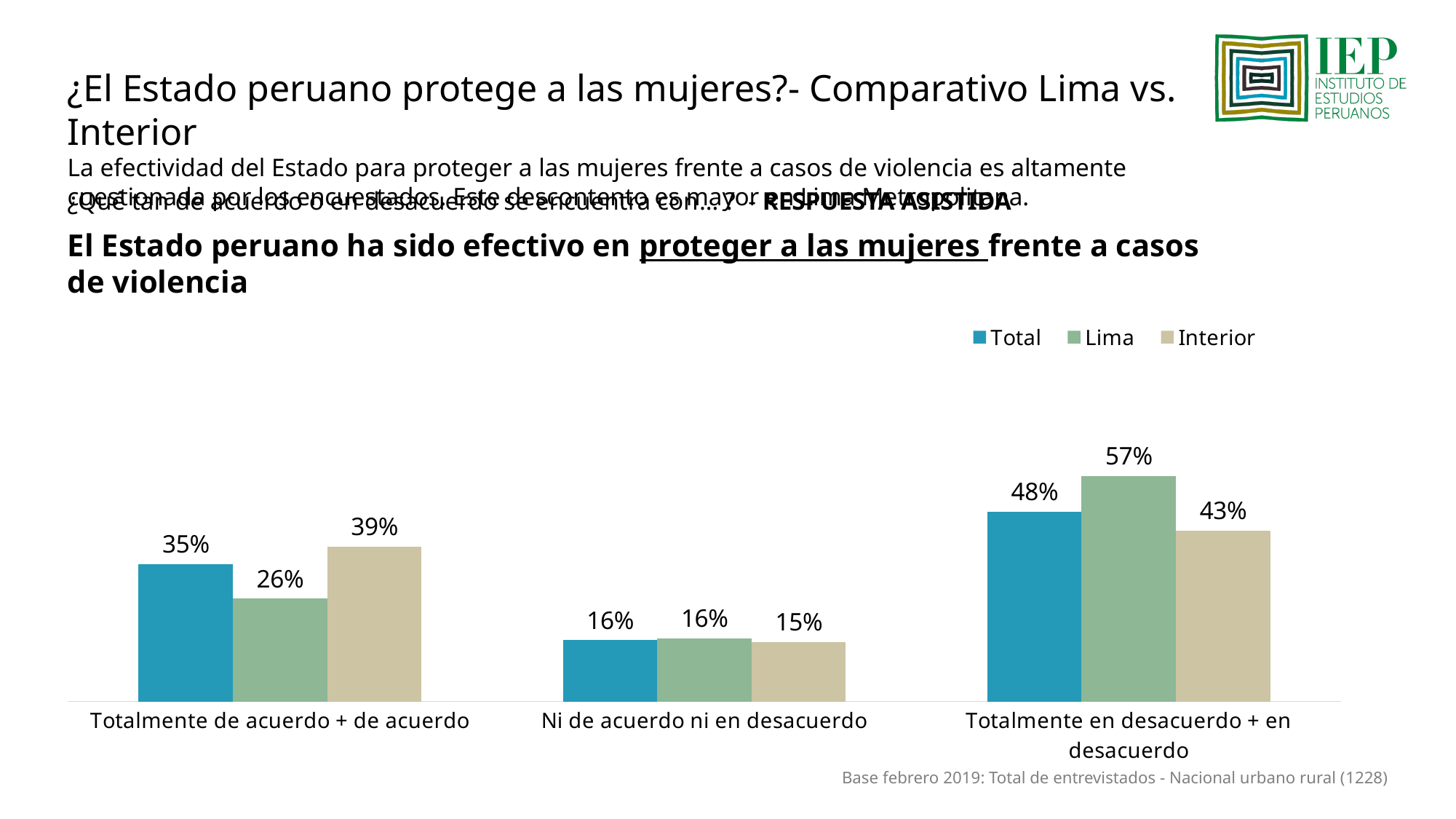
Which series is shown in blue in the legend? Total What is the Total value for "Ni de acuerdo ni en desacuerdo"? 16% What is the difference between the Lima and Interior values for "Totalmente en desacuerdo + en desacuerdo"? 14% What kind of chart is shown on the slide? Bar chart What is the difference between the Interior and Lima values for "Totalmente de acuerdo + de acuerdo"? 13% Which category has the lowest Interior value? Ni de acuerdo ni en desacuerdo How many categories are shown on the x axis? 3 What is the Lima value for "Totalmente en desacuerdo + en desacuerdo"? 57% How many series does the legend list? 3 Which category has the highest Lima value? Totalmente en desacuerdo + en desacuerdo For "Totalmente de acuerdo + de acuerdo", which is larger: the Total value or the Lima value? Total What is the Interior value for "Totalmente de acuerdo + de acuerdo"? 39%